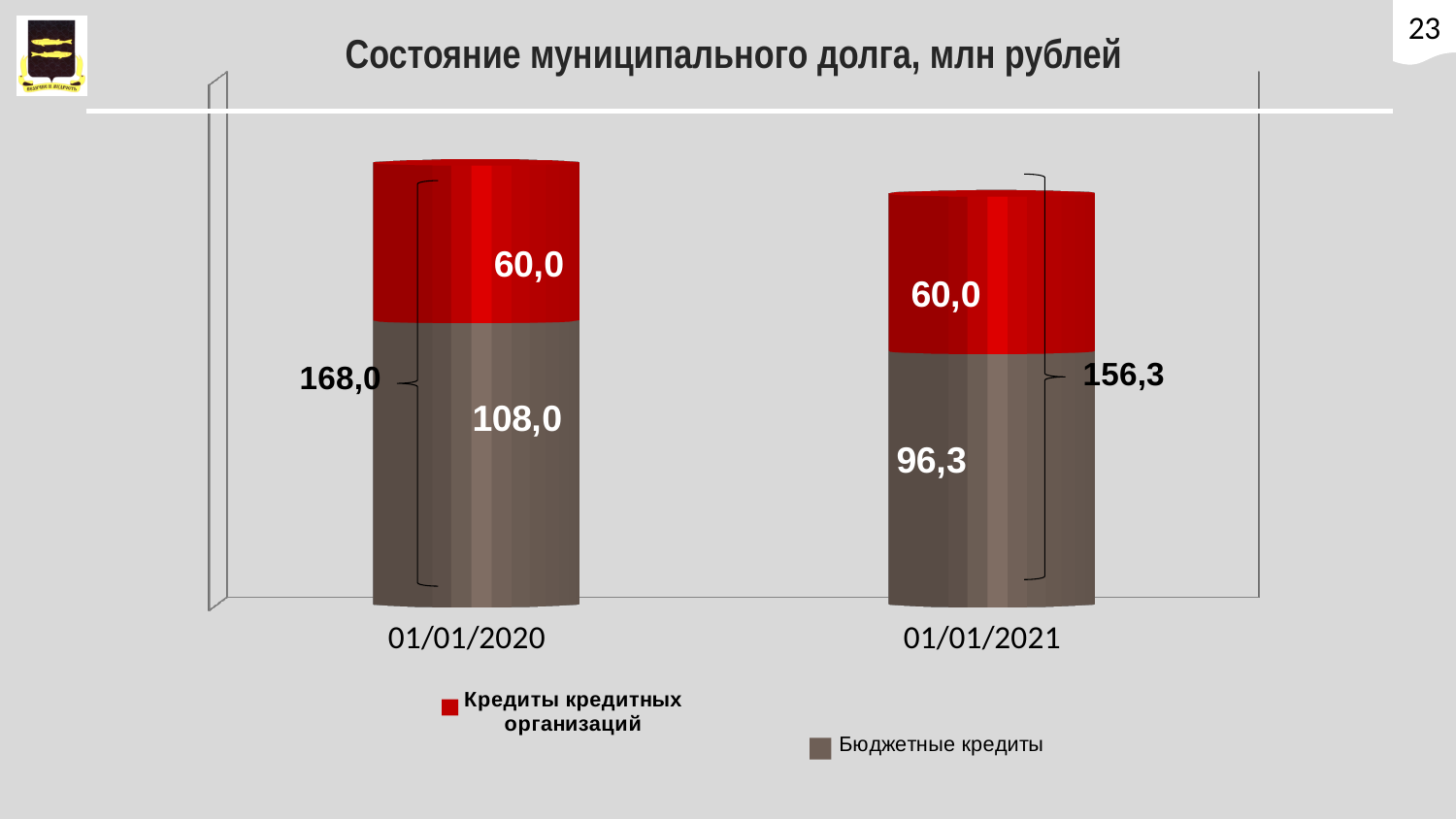
How many series does the legend list? 2 What is the total municipal debt shown for 01/01/2020? 168,0 Is the Бюджетные кредиты value larger on 01/01/2020 or on 01/01/2021? 01/01/2020 How many dates (categories) are shown on the chart? 2 What is the value of Бюджетные кредиты for 01/01/2020? 108,0 What is the difference between the Бюджетные кредиты values for 01/01/2020 and 01/01/2021? 11,7 Which colour represents Кредиты кредитных организаций in the chart? Red What is the value of Бюджетные кредиты for 01/01/2021? 96,3 What kind of chart is shown on the slide? Stacked bar chart Which date has the higher total municipal debt? 01/01/2020 What is the total municipal debt shown for 01/01/2021? 156,3 What is the value of Кредиты кредитных организаций for 01/01/2021? 60,0